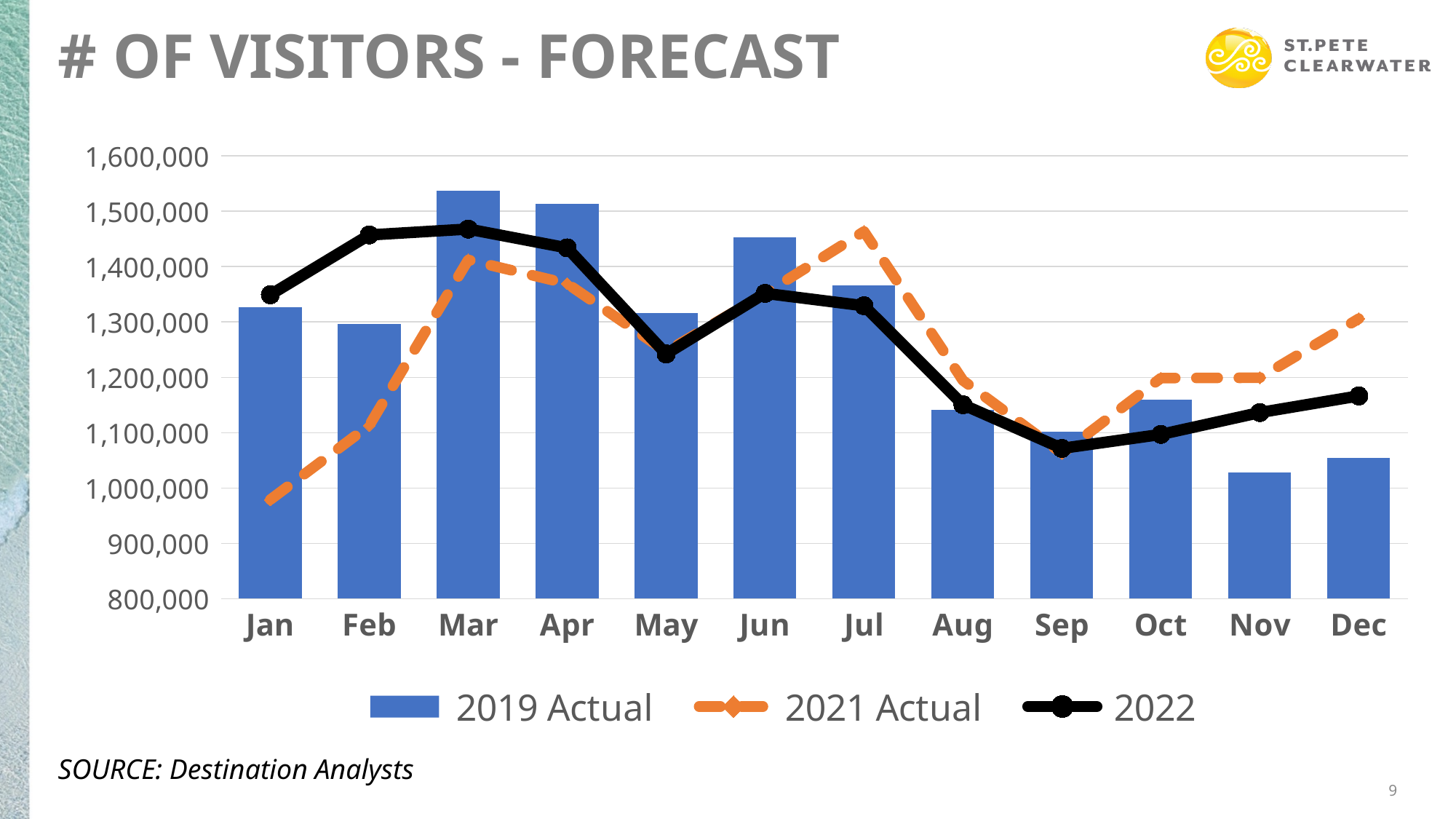
How many series does the legend list? 3 Which month has the highest 2021 Actual value? Jul Which month has the lowest 2019 Actual value? Nov Which month has the highest 2019 Actual value? Mar Is the 2021 Actual value for Jan greater or less than 1,000,000? less Which month has the lowest 2022 value? Sep How many months are shown on the x axis? 12 Is the 2022 value for Feb greater or less than 1,400,000? greater In Jun, which is larger: the 2019 Actual value or the 2022 value? 2019 Actual Do the 2019 Actual values rise or fall from Jul to Nov? fall Is the 2019 Actual value for Mar greater or less than 1,500,000? greater What kind of chart is shown on the slide? A combination bar and line chart